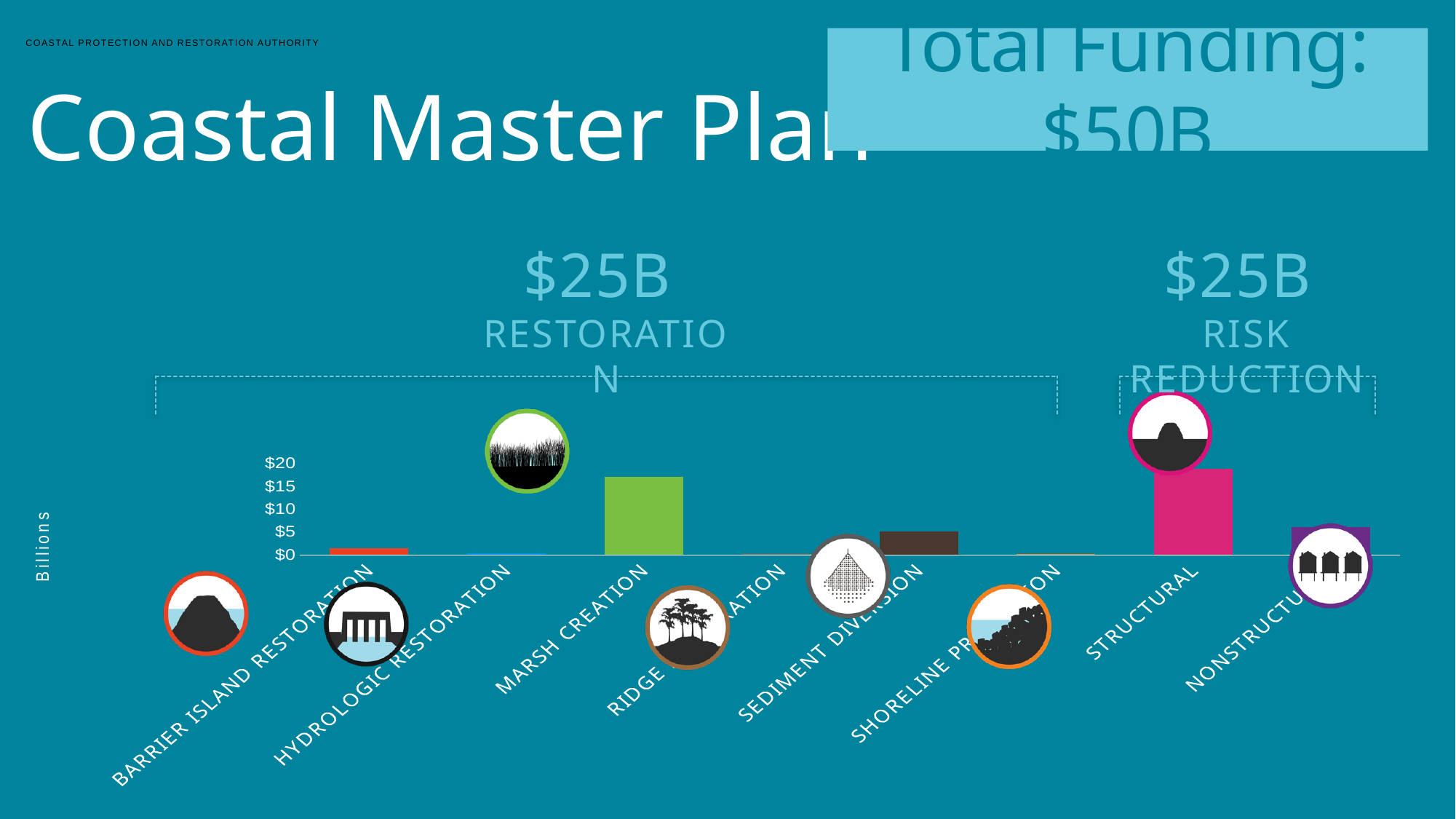
What unit is shown on the vertical axis label of the chart? Billions Is the value for Sediment Diversion greater or less than $10? less Which is larger, the value for Sediment Diversion or the value for Barrier Island Restoration? Sediment Diversion Is the value for Marsh Creation greater or less than $10? greater Which is larger, the value for Structural or the value for Barrier Island Restoration? Structural Is the value for Hydrologic Restoration greater or less than $5? less Which is larger, the value for Marsh Creation or the value for Sediment Diversion? Marsh Creation How many categories are plotted along the x axis of the chart? 8 What is the highest tick value shown on the vertical axis of the chart? $20 What kind of chart is shown on the slide? bar chart